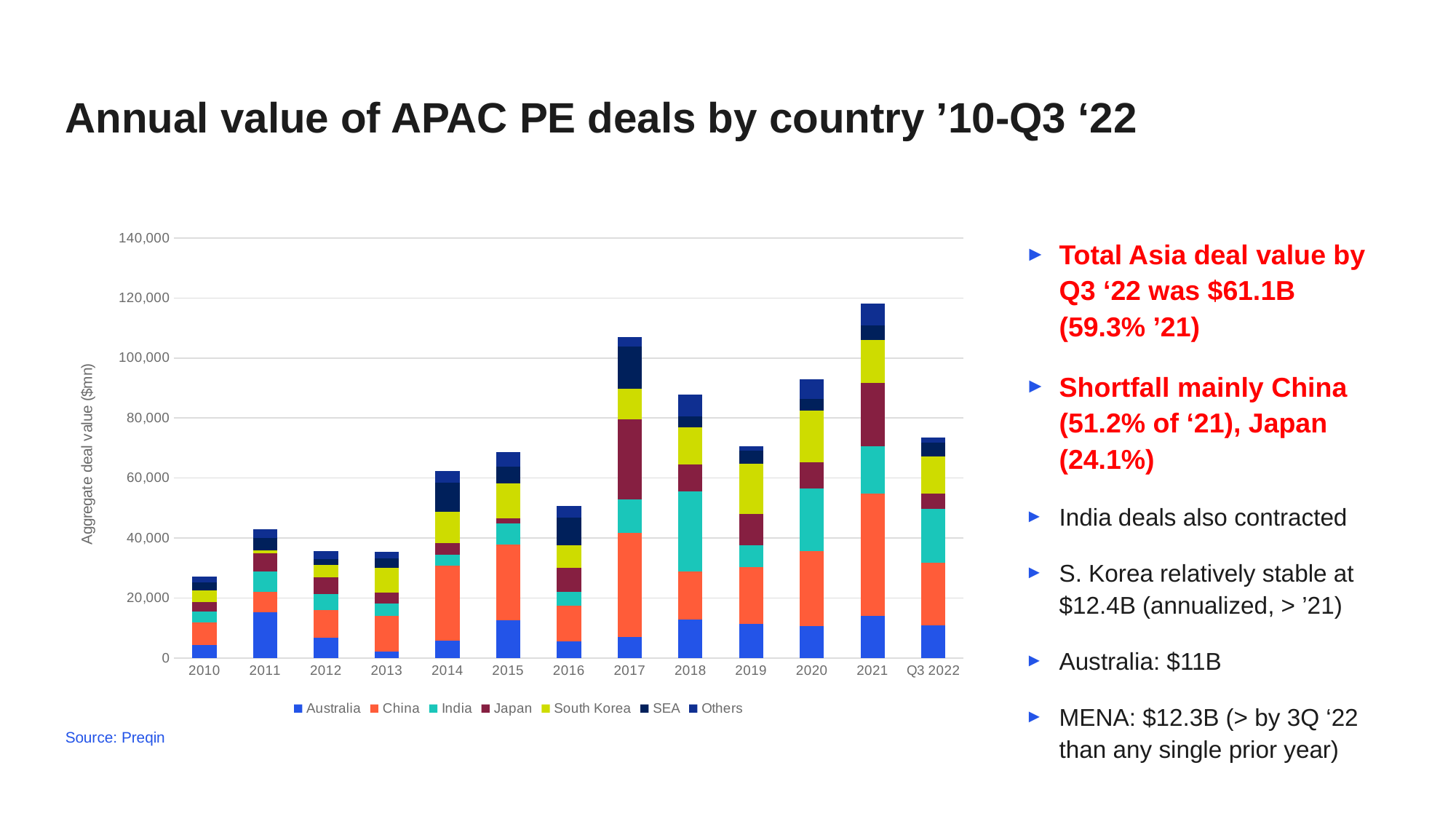
What kind of chart is shown on the slide? Stacked bar chart What source is cited for the chart? Preqin Which year has the highest total aggregate deal value? 2021 Which year has the lowest total aggregate deal value? 2010 Is the total aggregate deal value for 2010 greater or less than 40,000? less Is the total aggregate deal value for 2021 greater or less than 100,000? greater How many series does the chart legend list? 7 What is the label on the y axis of the chart? Aggregate deal value ($mn) Do the total aggregate deal values rise or fall from 2013 to 2017? rise Which year has the larger total aggregate deal value, 2017 or 2018? 2017 How many bars (time periods) are plotted along the x axis? 13 Is the total aggregate deal value for Q3 2022 greater or less than 80,000? less